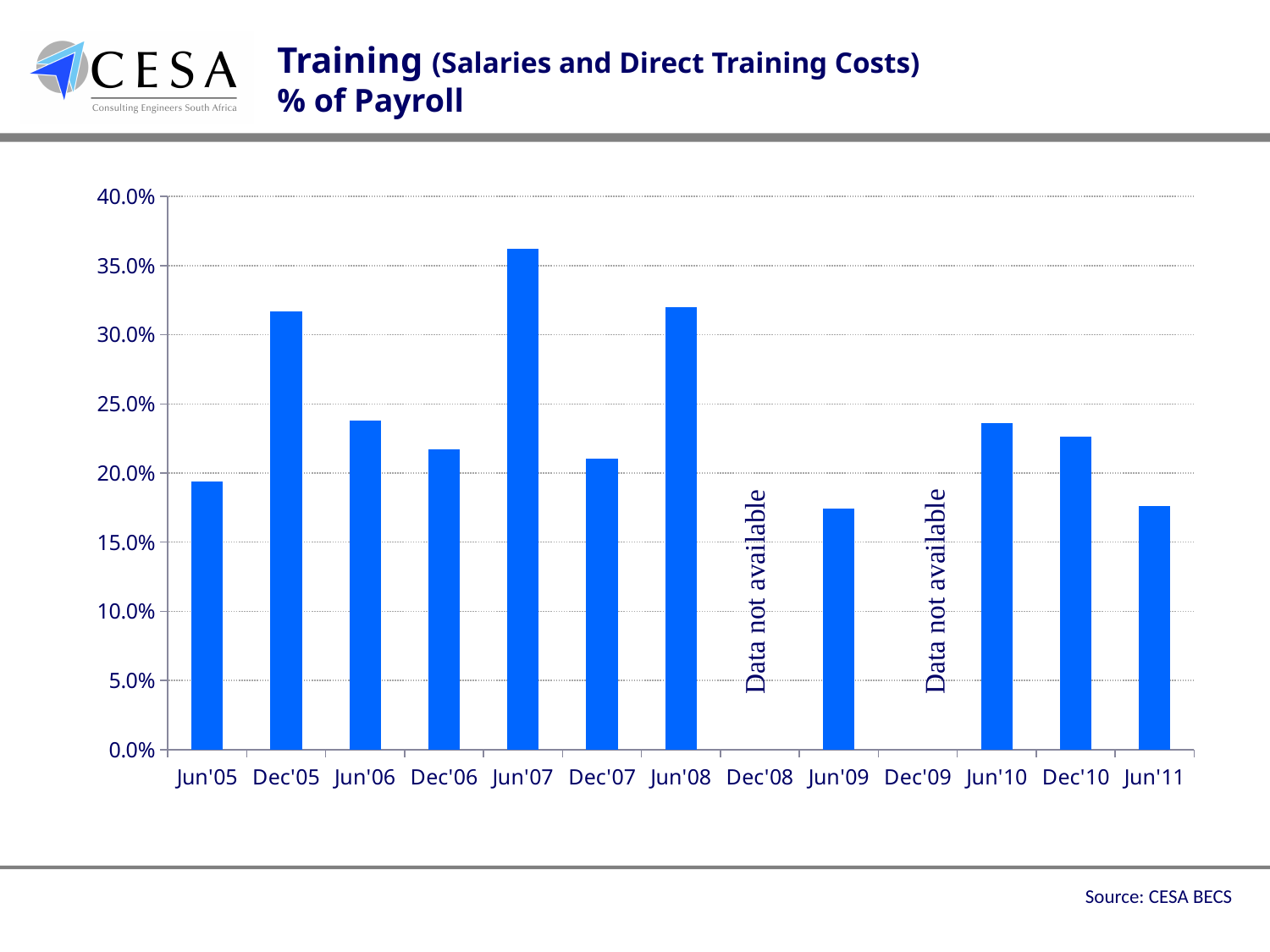
What kind of chart is shown on the slide? bar chart Is the value for Jun'07 greater or less than 35.0%? greater Which is larger, the value for Jun'10 or the value for Jun'11? Jun'10 What is the source cited for the chart? CESA BECS Is the value for Jun'05 greater or less than 20.0%? less Which period has the highest training cost as a % of payroll? Jun'07 Is the value for Jun'06 greater or less than 25.0%? less For which periods is data marked as not available? Dec'08 and Dec'09 How many periods are labelled on the x axis? 13 Which is larger, the value for Jun'07 or the value for Dec'07? Jun'07